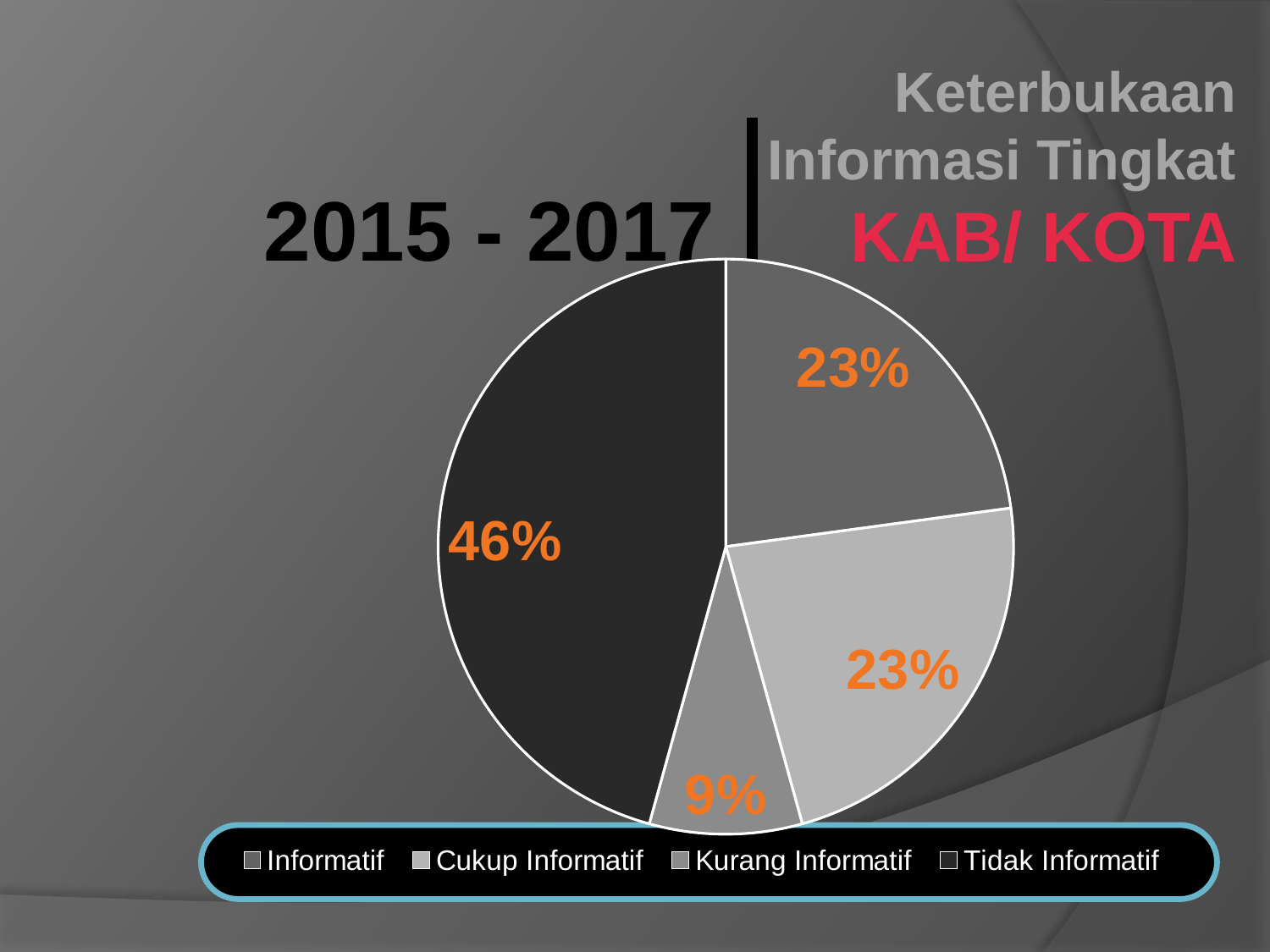
What period is shown in the heading to the left of the chart? 2015 - 2017 How many slices does the pie chart have? 4 What share of the pie is Kurang Informatif? 9% What share of the pie is Informatif? 23% How many entries does the legend list? 4 Which category has the smallest slice of the pie? Kurang Informatif What share of the pie is Tidak Informatif? 46% Which category has the largest slice of the pie? Tidak Informatif What kind of chart is shown on the slide? pie chart Which is larger, the Tidak Informatif slice or the Informatif slice? Tidak Informatif What is the difference in percentage points between Tidak Informatif and Kurang Informatif? 37